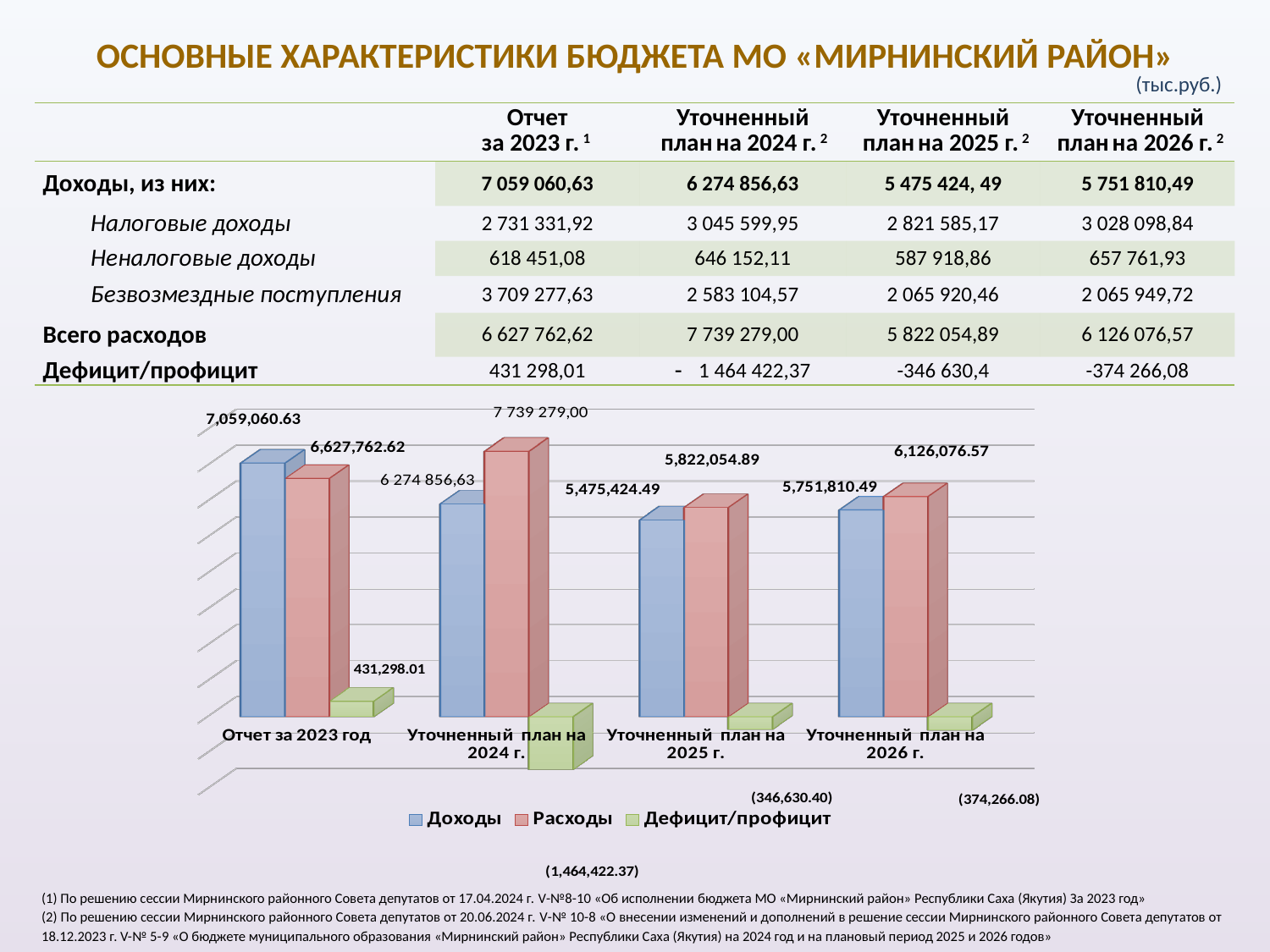
How many categories are shown along the x axis of the chart? 4 In which category is the Доходы bar the lowest? Уточненный план на 2025 г. What is the difference between Расходы for Уточненный план на 2024 г. and Расходы for Отчет за 2023 год? 1,111,516.38 What is the value of Доходы for Отчет за 2023 год in the chart? 7,059,060.63 For Отчет за 2023 год, which is larger: Доходы or Расходы? Доходы What is the value of Дефицит/профицит for Уточненный план на 2025 г. in the chart? (346,630.40) Which series is shown in green in the chart legend? Дефицит/профицит What is the value of Доходы for Уточненный план на 2026 г. in the chart? 5,751,810.49 In which category is the Расходы bar the highest? Уточненный план на 2024 г. What kind of chart is shown on the slide? bar chart What is the value of Расходы for Уточненный план на 2024 г. in the chart? 7 739 279,00 How many series does the chart legend list? 3